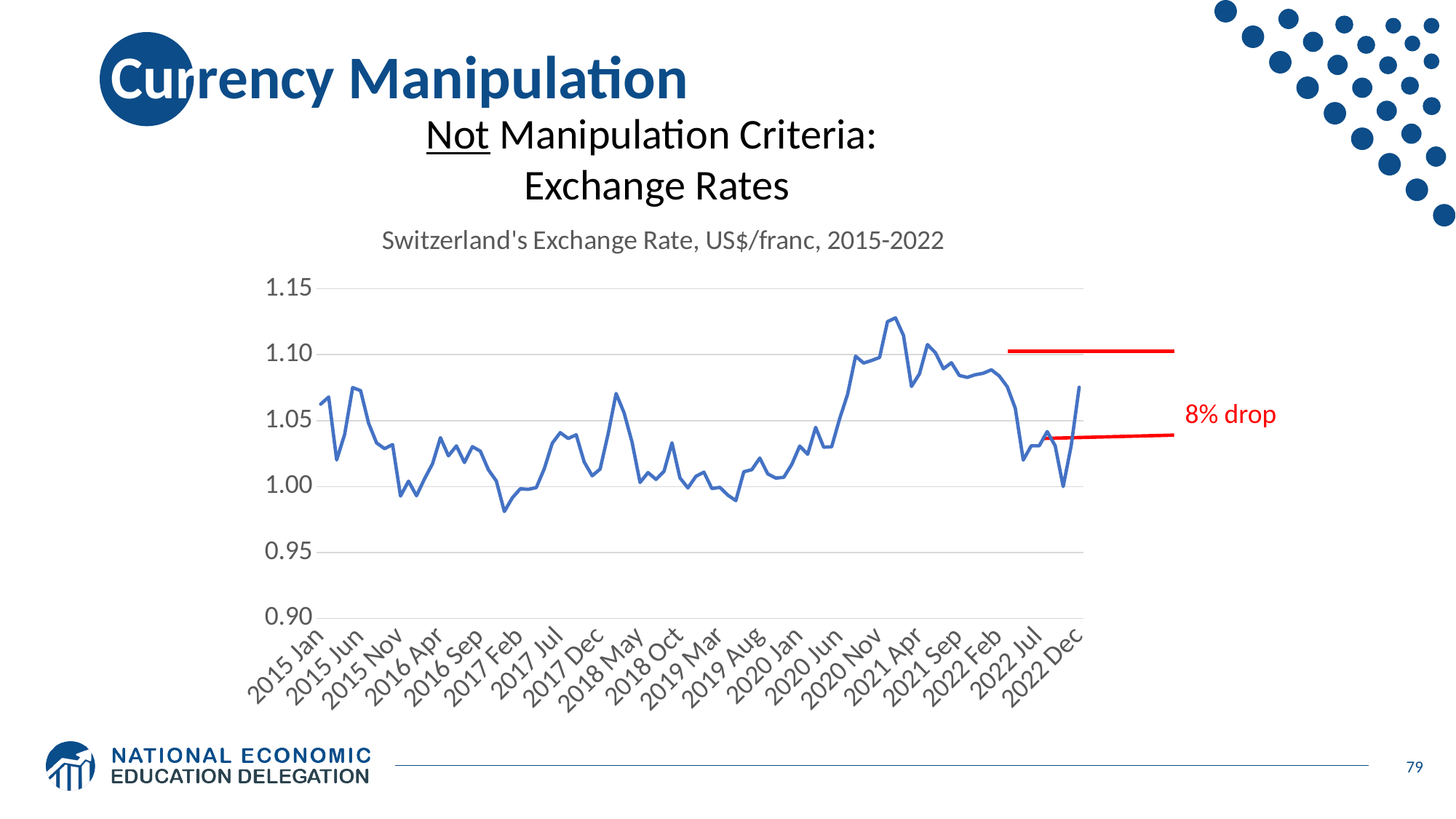
Is the value for 2022 Dec greater or less than 1.05? greater Which is larger, the value for 2015 Jan or the value for 2017 Feb? 2015 Jan Is the value for 2015 Jan greater or less than 1.05? greater Is the highest point on the line greater or less than 1.10? greater What is the title of the chart? Switzerland's Exchange Rate, US$/franc, 2015-2022 Does the exchange rate rise or fall between 2022 Feb and 2022 Jul? fall Does the exchange rate rise or fall between 2019 Aug and 2020 Nov? rise What does the red annotation on the chart say? 8% drop What kind of chart is shown on the slide? Line chart